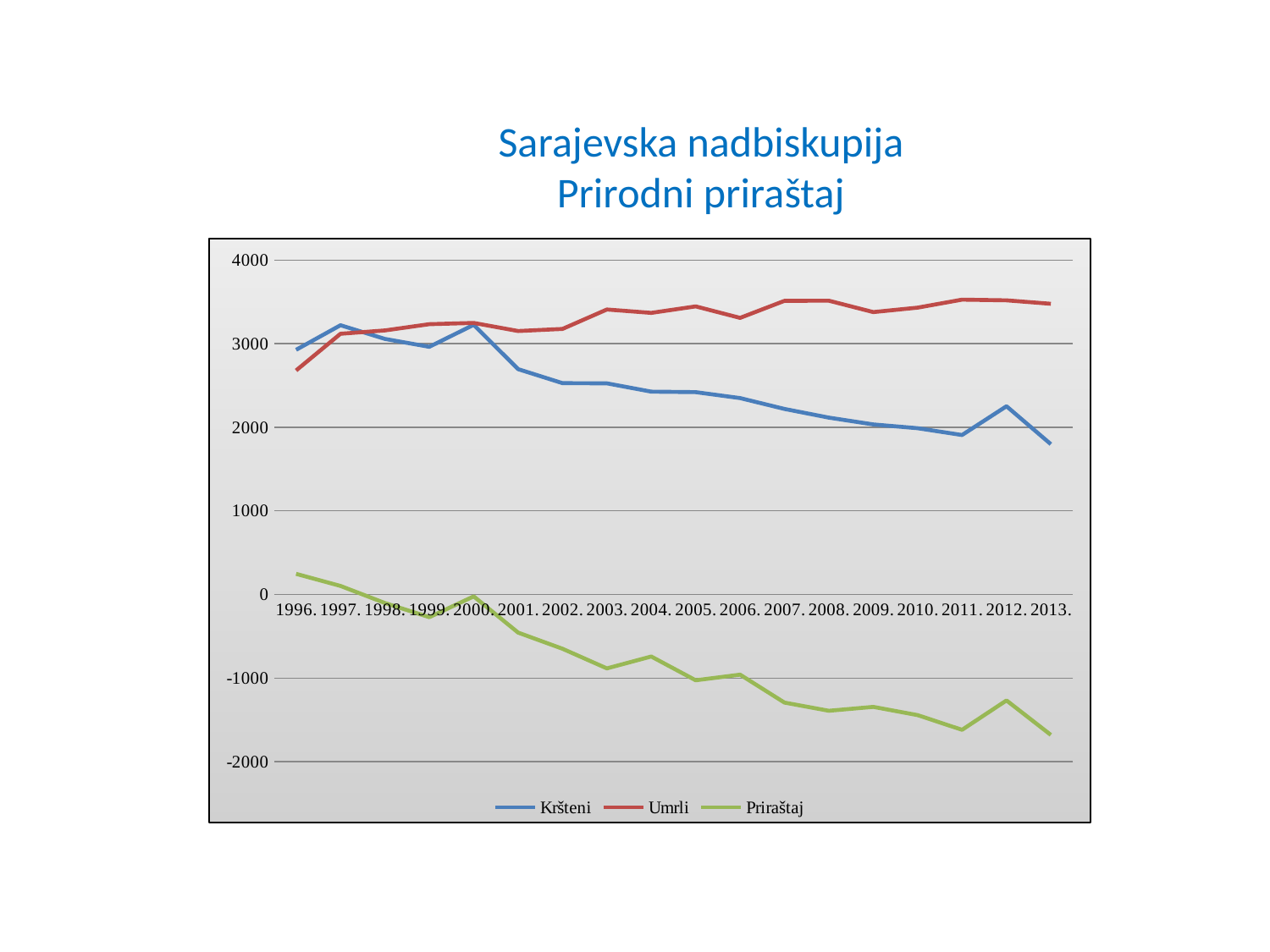
Does the Priraštaj series generally rise or fall from 1996 to 2013? fall Which series is drawn in green in the chart? Priraštaj In 2013, which series has the larger value, Kršteni or Umrli? Umrli How many series does the legend list? 3 Is the value for Priraštaj in 1996 greater or less than 0? greater In 1996, which series has the larger value, Kršteni or Umrli? Kršteni Is the value for Umrli in 2013 greater or less than 3000? greater Is the value for Priraštaj in 2013 greater or less than -1000? less How many years are plotted along the x axis? 18 What kind of chart is shown on the slide? line chart Does the Kršteni series generally rise or fall from 1996 to 2013? fall